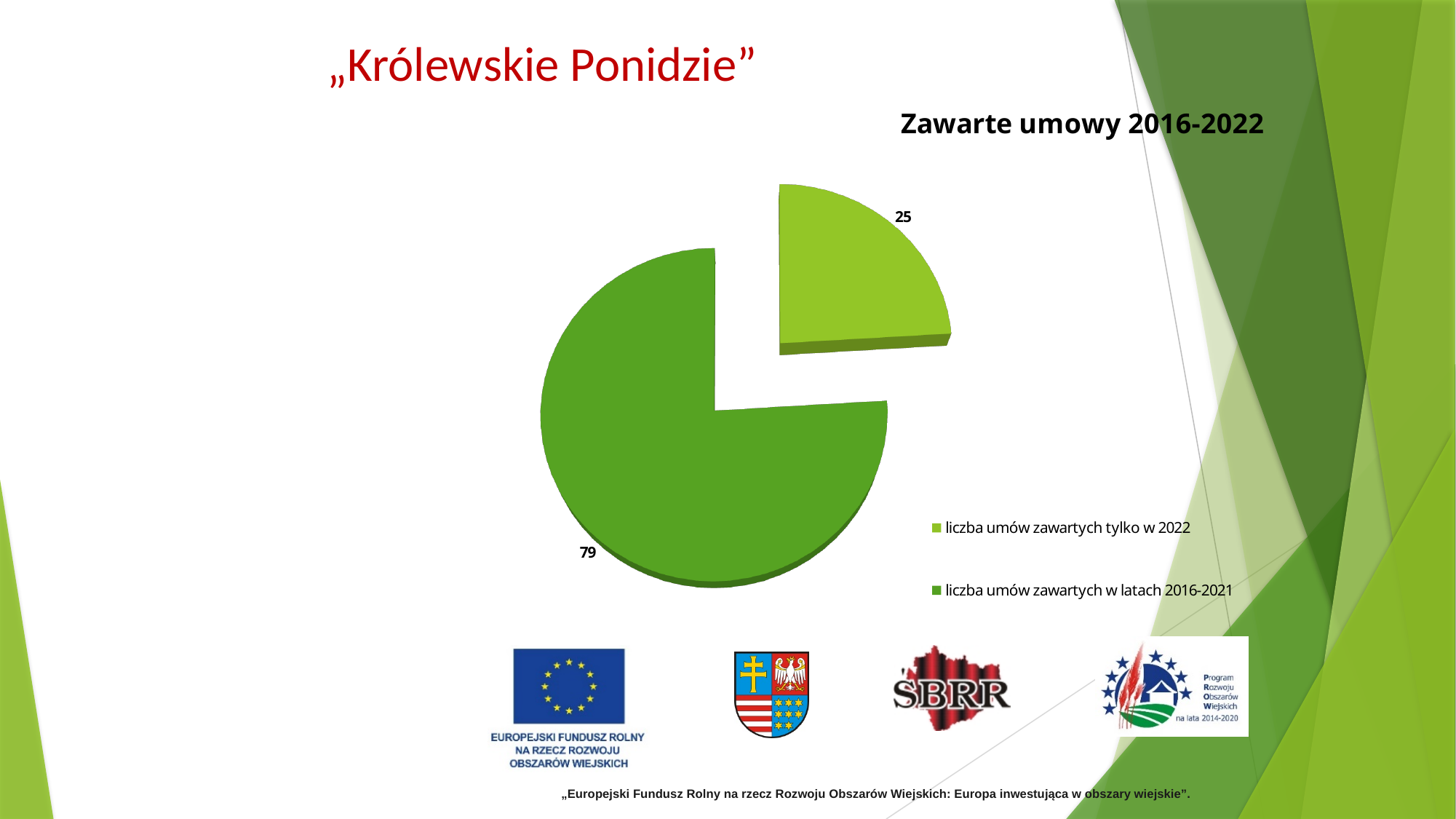
What is the total of the two values shown in the pie chart? 104 How many slices does the pie chart have? 2 What is the value for 'liczba umów zawartych tylko w 2022'? 25 What is the value for 'liczba umów zawartych w latach 2016-2021'? 79 What is the difference between the number of contracts concluded in 2016-2021 and those concluded only in 2022? 54 Which category has the largest slice of the pie? liczba umów zawartych w latach 2016-2021 What kind of chart is shown on the slide? pie chart Which category has the smallest slice of the pie? liczba umów zawartych tylko w 2022 Which is larger: the number of contracts concluded only in 2022 or the number concluded in 2016-2021? liczba umów zawartych w latach 2016-2021 Which legend entry is shown in the lighter green colour? liczba umów zawartych tylko w 2022 What is the title of the chart? Zawarte umowy 2016-2022 How many entries does the chart legend list? 2